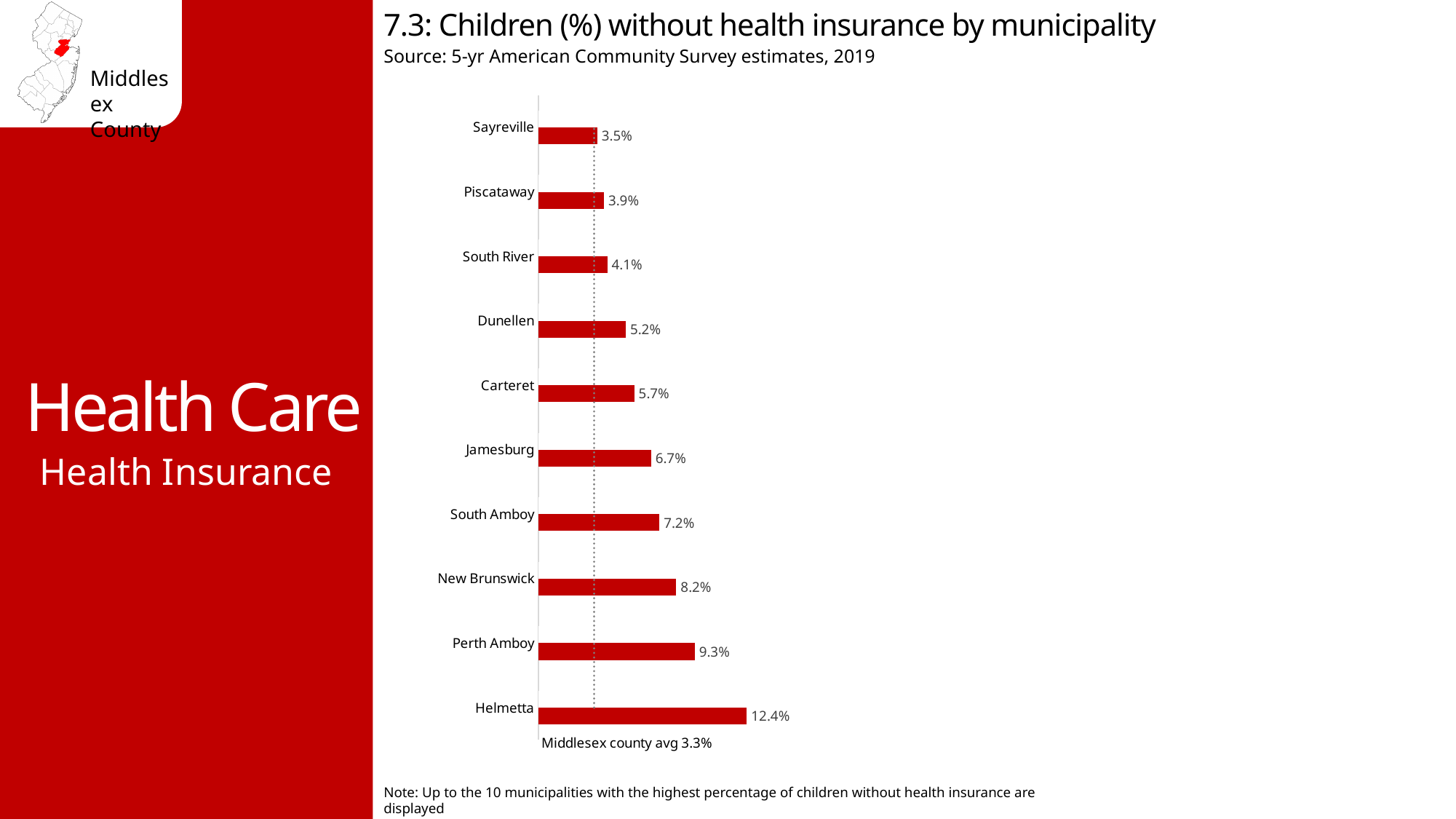
What percentage is shown for Sayreville? 3.5% What kind of chart is shown on the slide? Bar chart What is the Middlesex county average shown on the chart? 3.3% What is the source of the data shown in the chart? 5-yr American Community Survey estimates, 2019 What is the value shown for New Brunswick? 8.2% Which has a higher percentage of children without health insurance, Carteret or Dunellen? Carteret What is the difference between the values for Helmetta and Perth Amboy? 3.1% Which municipality has the lowest percentage of children without health insurance on the chart? Sayreville What percentage of children are without health insurance in Helmetta? 12.4% Which municipality has the highest percentage of children without health insurance? Helmetta What is the difference between the values for South Amboy and Jamesburg? 0.5% How many municipalities are shown on the chart? 10